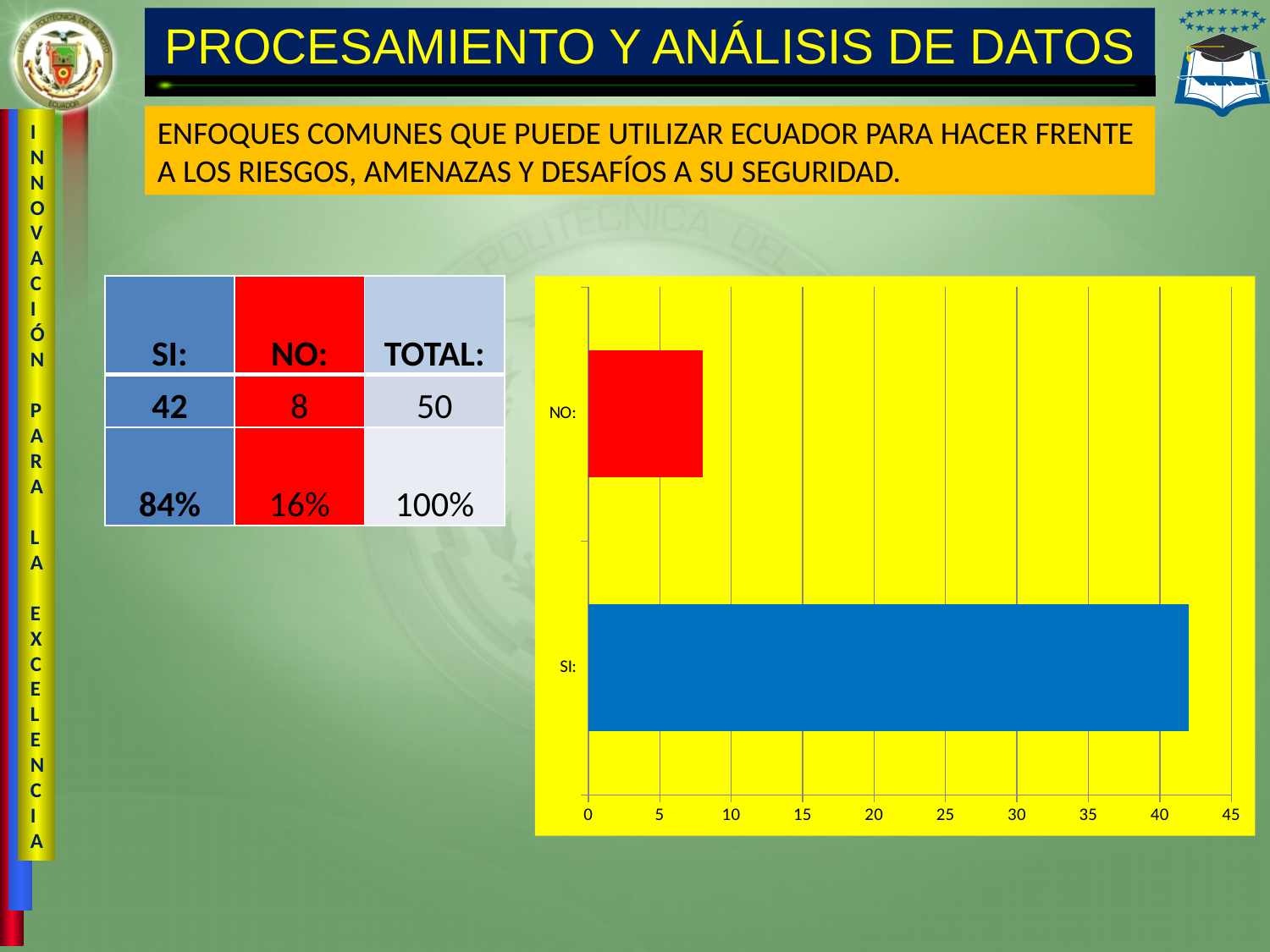
What is the difference between the SI: and NO: values? 34 What kind of chart is shown on the slide? bar chart Is the value for NO: greater or less than 10? less Is the value for SI: greater or less than 40? greater What is the value for SI: in the chart? 42 Which bar is longer, SI: or NO:? SI: What is the highest value shown on the horizontal axis of the chart? 45 Which category has the longest bar in the chart? SI: How many categories does the bar chart show? 2 What colour is the bar for NO:? red What is the value for NO: in the chart? 8 Which category has the shortest bar in the chart? NO: